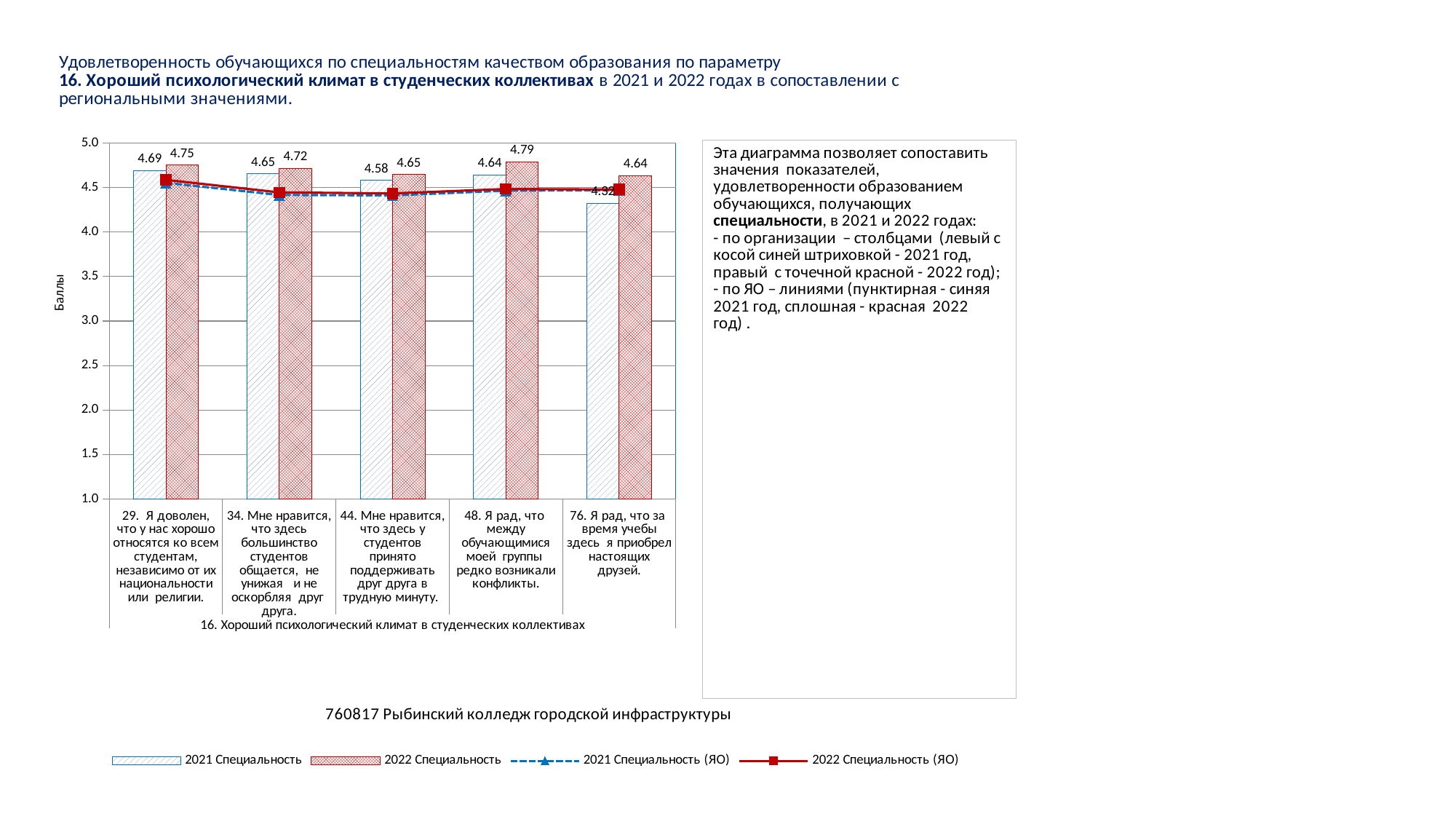
How many survey items (categories) are shown on the x axis? 5 Which item has the lowest 2021 Специальность value? 76. Я рад, что за время учебы здесь я приобрел настоящих друзей. What is the difference between the 2022 and 2021 Специальность values for item 76? 0.32 What is the label of the vertical axis? Баллы What is the 2021 Специальность value for item 29 (Я доволен, что у нас хорошо относятся ко всем студентам)? 4.69 Which item has the highest 2022 Специальность value? 48. Я рад, что между обучающимися моей группы редко возникали конфликты. What is the 2021 Специальность value for item 76 (Я рад, что за время учебы здесь я приобрел настоящих друзей)? 4.32 For item 44, which is larger: the 2021 Специальность value or the 2022 Специальность value? 2022 Специальность What is the 2022 Специальность value for item 34 (Мне нравится, что здесь большинство студентов общается, не унижая и не оскорбляя друг друга)? 4.72 What is the 2022 Специальность value for item 48 (Я рад, что между обучающимися моей группы редко возникали конфликты)? 4.79 How many series does the legend list? 4 Is the 2021 Специальность value for item 76 greater or less than 4.5? less